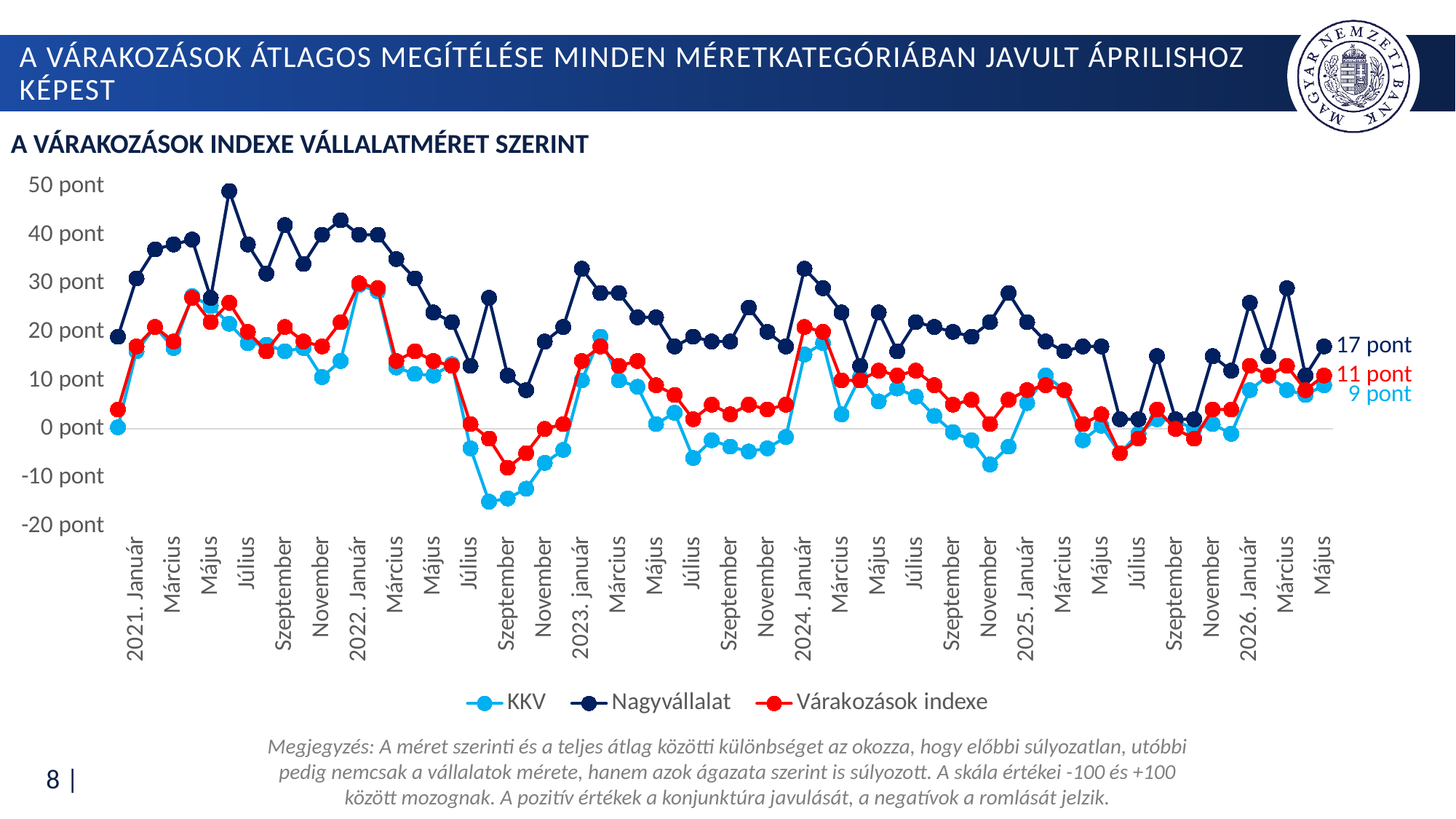
Is the value for KKV in 2022 Szeptember greater or less than -10 pont? less At the right end of the chart, what is the difference between the Nagyvállalat value and the Várakozások indexe value? 6 pont What is the latest value shown for the KKV series at the right end of the chart? 9 pont Which series is drawn in red according to the legend? Várakozások indexe Is the peak value of the Nagyvállalat series in 2021 greater or less than 40 pont? greater How many series does the legend list? 3 At the right end of the chart, which series has the highest value? Nagyvállalat At the right end of the chart, which series has the lowest value? KKV What is the latest value shown for the Várakozások indexe series at the right end of the chart? 11 pont At the right end of the chart, what is the difference between the Nagyvállalat value and the KKV value? 8 pont What is the latest value shown for the Nagyvállalat series at the right end of the chart? 17 pont What kind of chart is shown on the slide? line chart